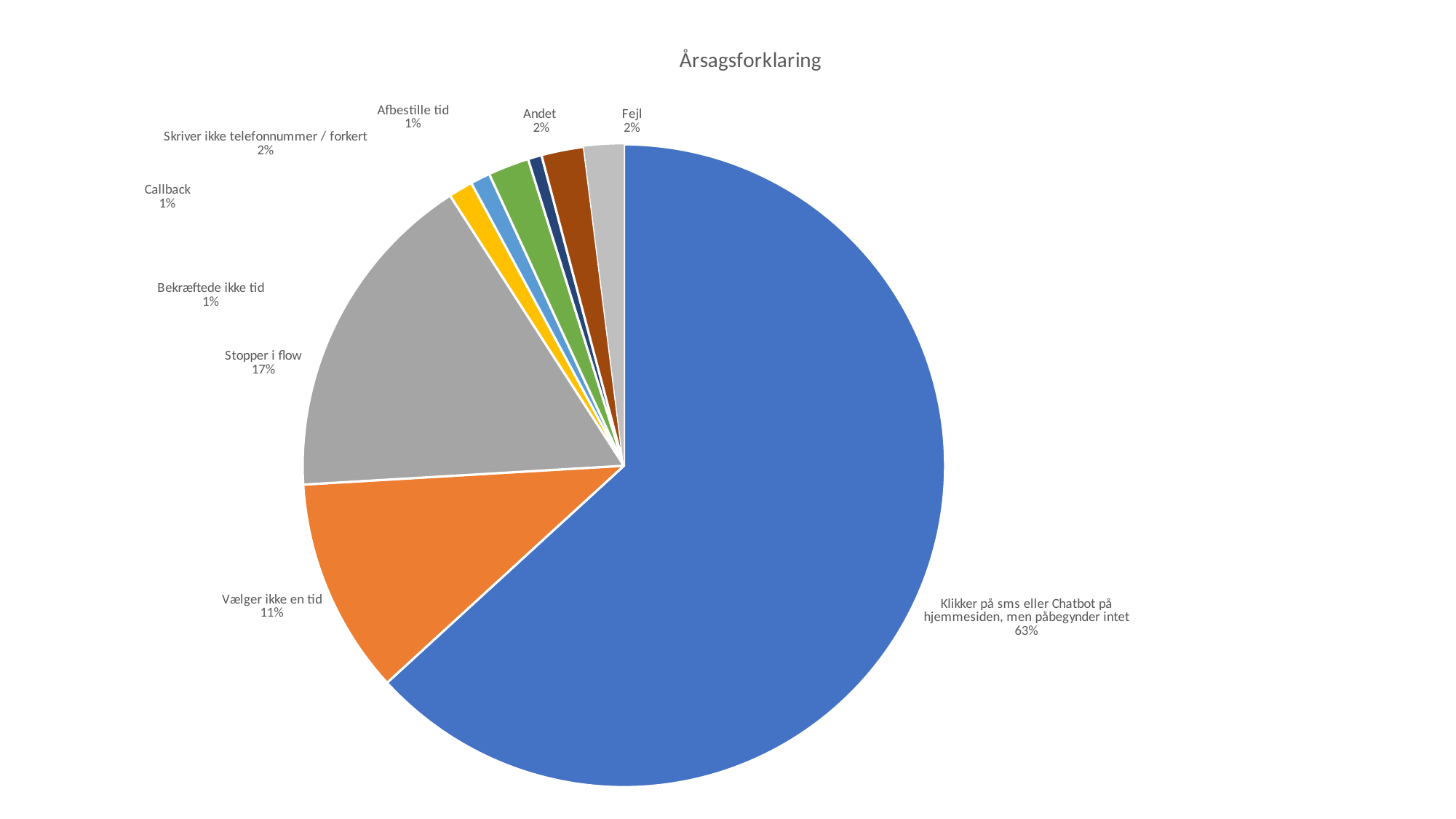
What type of chart is shown on the slide? Pie chart How many slices does the pie chart have? 9 Which is larger, "Stopper i flow" or "Vælger ikke en tid"? Stopper i flow What is the title of the chart? Årsagsforklaring What share of the pie does "Stopper i flow" represent? 17% What is the difference in percentage points between "Stopper i flow" and "Vælger ikke en tid"? 6 What percentage is shown for "Klikker på sms eller Chatbot på hjemmesiden, men påbegynder intet"? 63% What percentage is shown for "Skriver ikke telefonnummer / forkert"? 2% What share of the pie does "Vælger ikke en tid" represent? 11% What colour is the largest slice of the pie? Blue Which category has the largest slice of the pie? Klikker på sms eller Chatbot på hjemmesiden, men påbegynder intet What percentage is shown for "Callback"? 1%